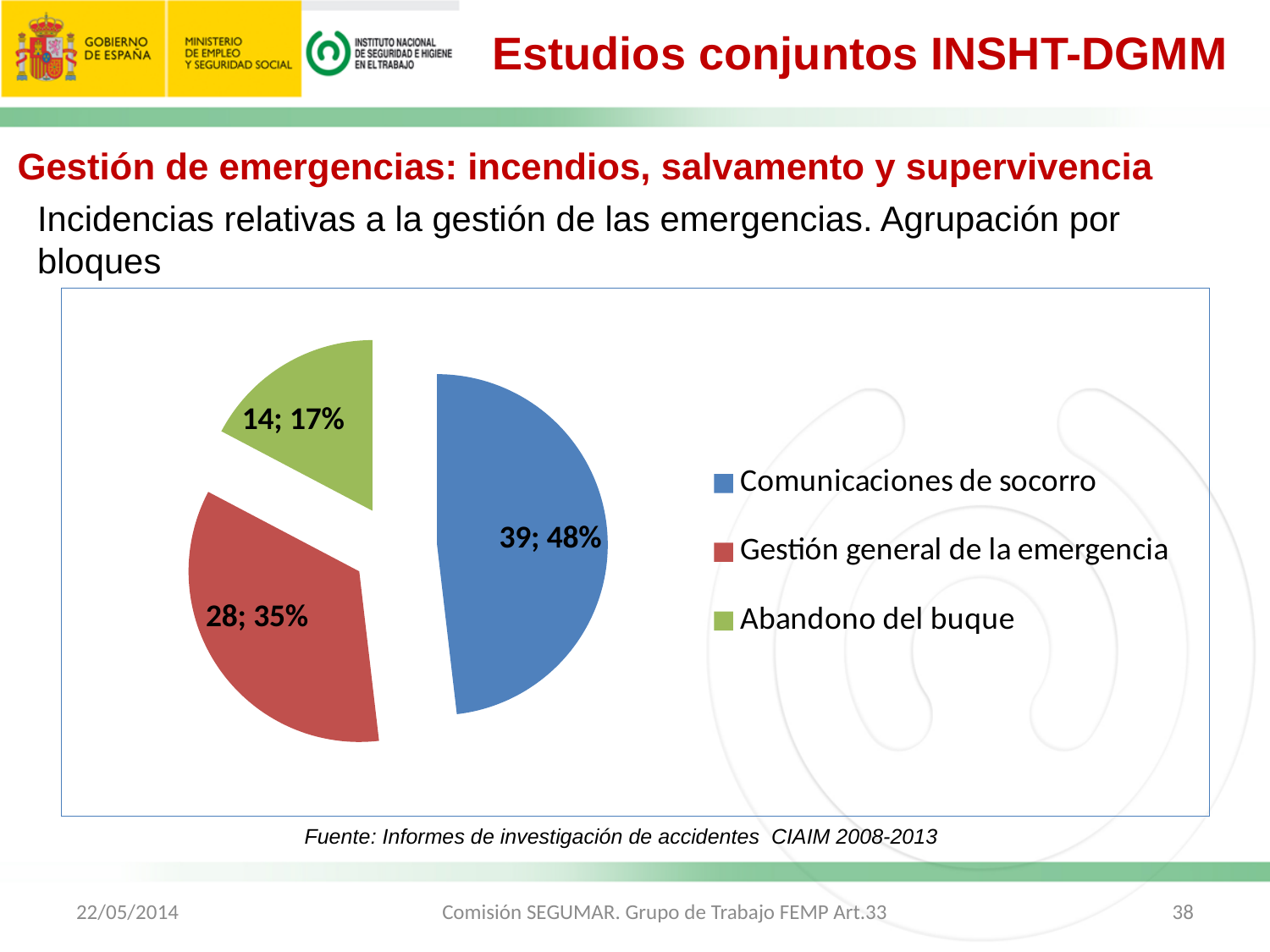
What is the count shown for Abandono del buque? 14 How many entries does the legend list? 3 Which category has the largest slice? Comunicaciones de socorro How many slices does the pie chart have? 3 What is the count shown for Comunicaciones de socorro? 39 Which category has the smallest slice? Abandono del buque What percentage share does Gestión general de la emergencia have? 35% What is the difference in count between Comunicaciones de socorro and Gestión general de la emergencia? 11 What colour is the slice for Abandono del buque? green Which is larger, the count for Gestión general de la emergencia or for Abandono del buque? Gestión general de la emergencia What kind of chart is shown on the slide? pie chart What percentage share does Comunicaciones de socorro have? 48%